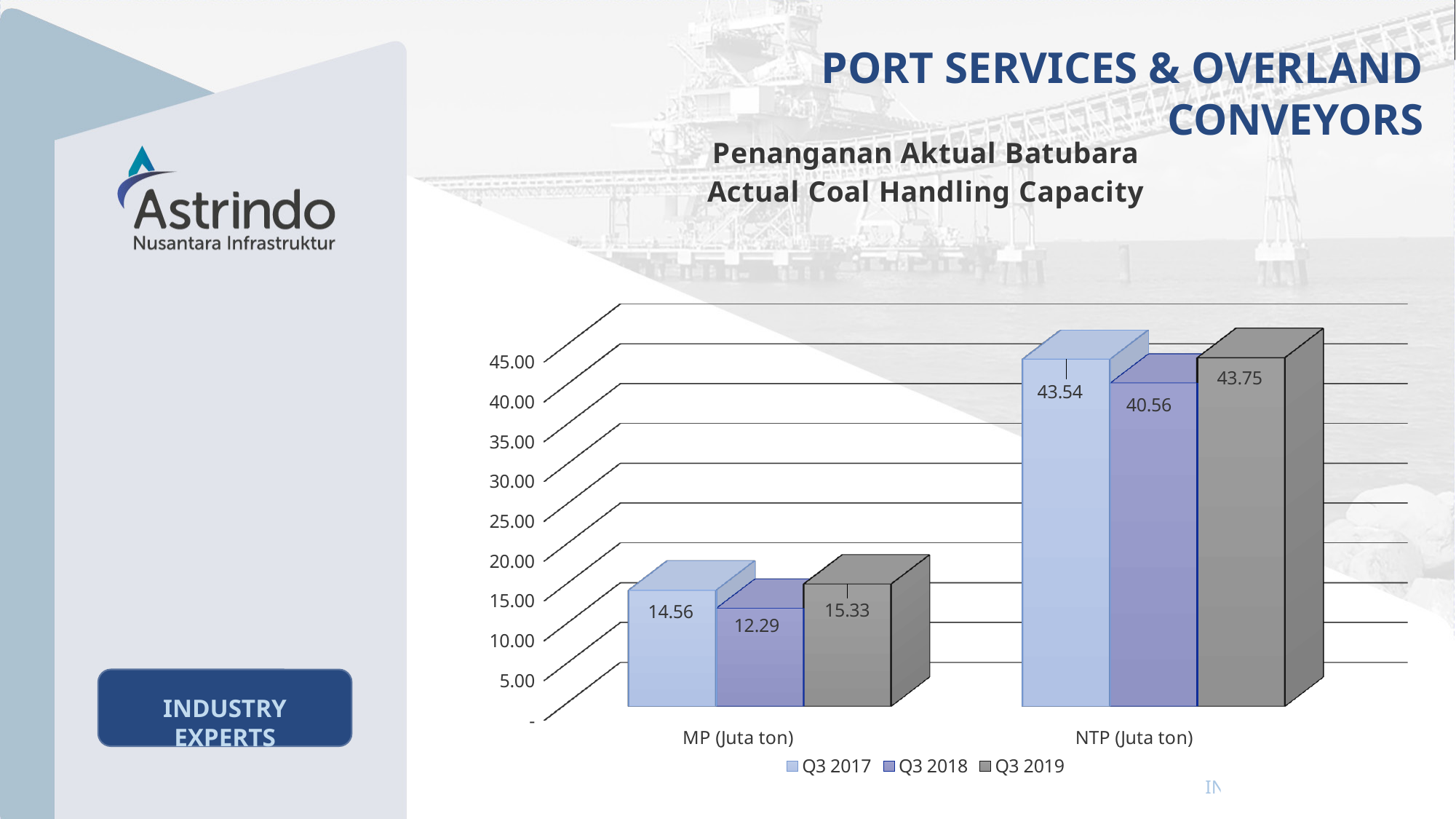
Which quarter has the lowest value for NTP (Juta ton)? Q3 2018 What is the Q3 2018 value for NTP (Juta ton)? 40.56 What kind of chart is shown on the slide? Bar chart How many categories are shown on the x axis? 2 What is the difference between the Q3 2017 and Q3 2018 values for NTP (Juta ton)? 2.98 What is the difference between the Q3 2019 and Q3 2018 values for MP (Juta ton)? 3.04 What is the Q3 2017 value for MP (Juta ton)? 14.56 Which quarter has the lowest value for MP (Juta ton)? Q3 2018 How many series does the legend list? 3 What is the Q3 2019 value for NTP (Juta ton)? 43.75 What is the Q3 2019 value for MP (Juta ton)? 15.33 Which is larger for MP (Juta ton): the Q3 2017 value or the Q3 2018 value? Q3 2017